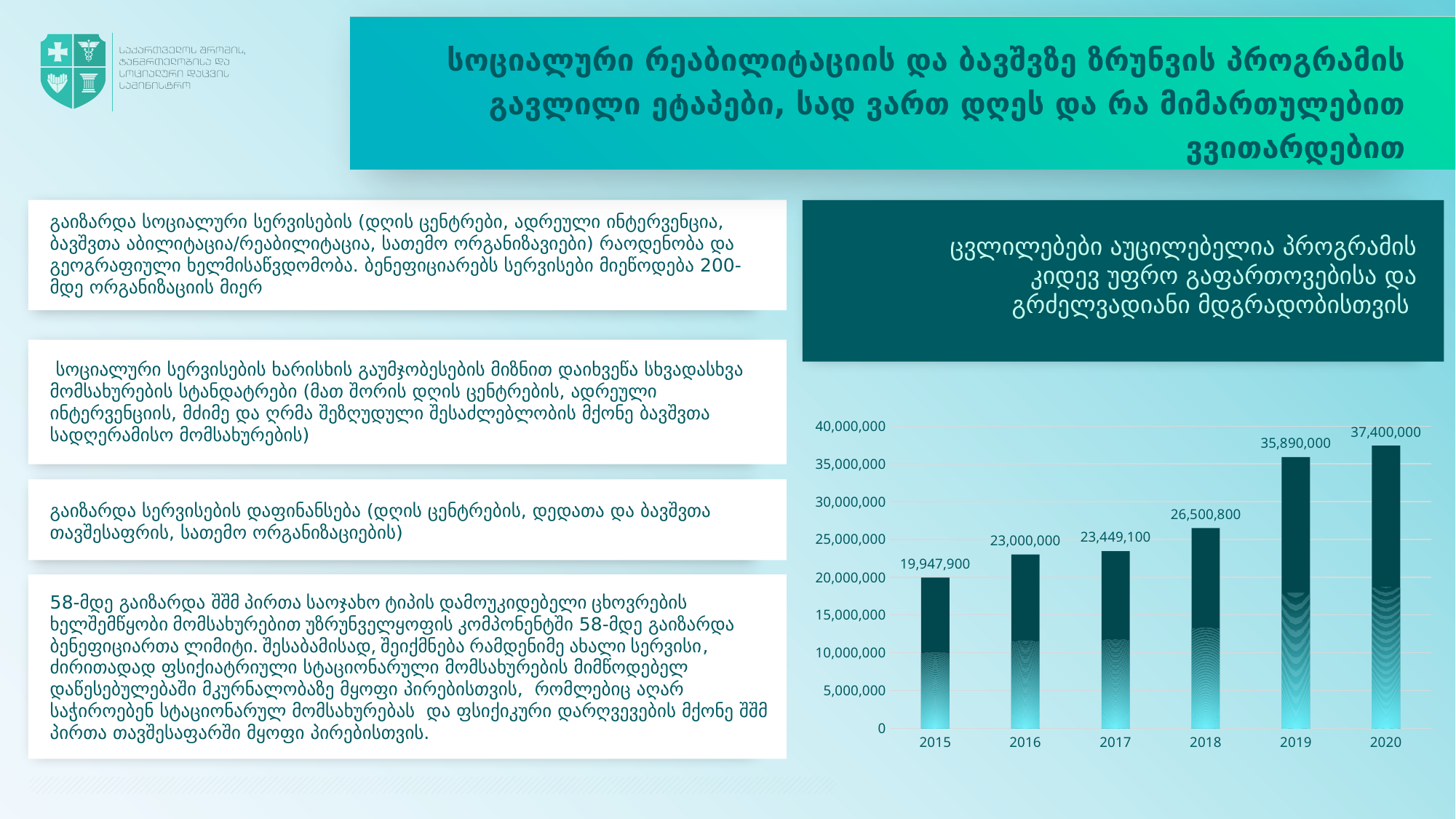
How many years are shown on the chart? 6 Which is larger, the value for 2018 or the value for 2017? 2018 What kind of chart is shown on the slide? bar chart What is the value for 2018? 26,500,800 What is the difference between the values for 2020 and 2019? 1,510,000 Which year has the highest value? 2020 Which year has the lowest value? 2015 What is the difference between the values for 2016 and 2015? 3,052,100 What is the value for 2015? 19,947,900 Is the value for 2019 greater or less than 30,000,000? greater What is the value for 2017? 23,449,100 What is the value for 2020? 37,400,000